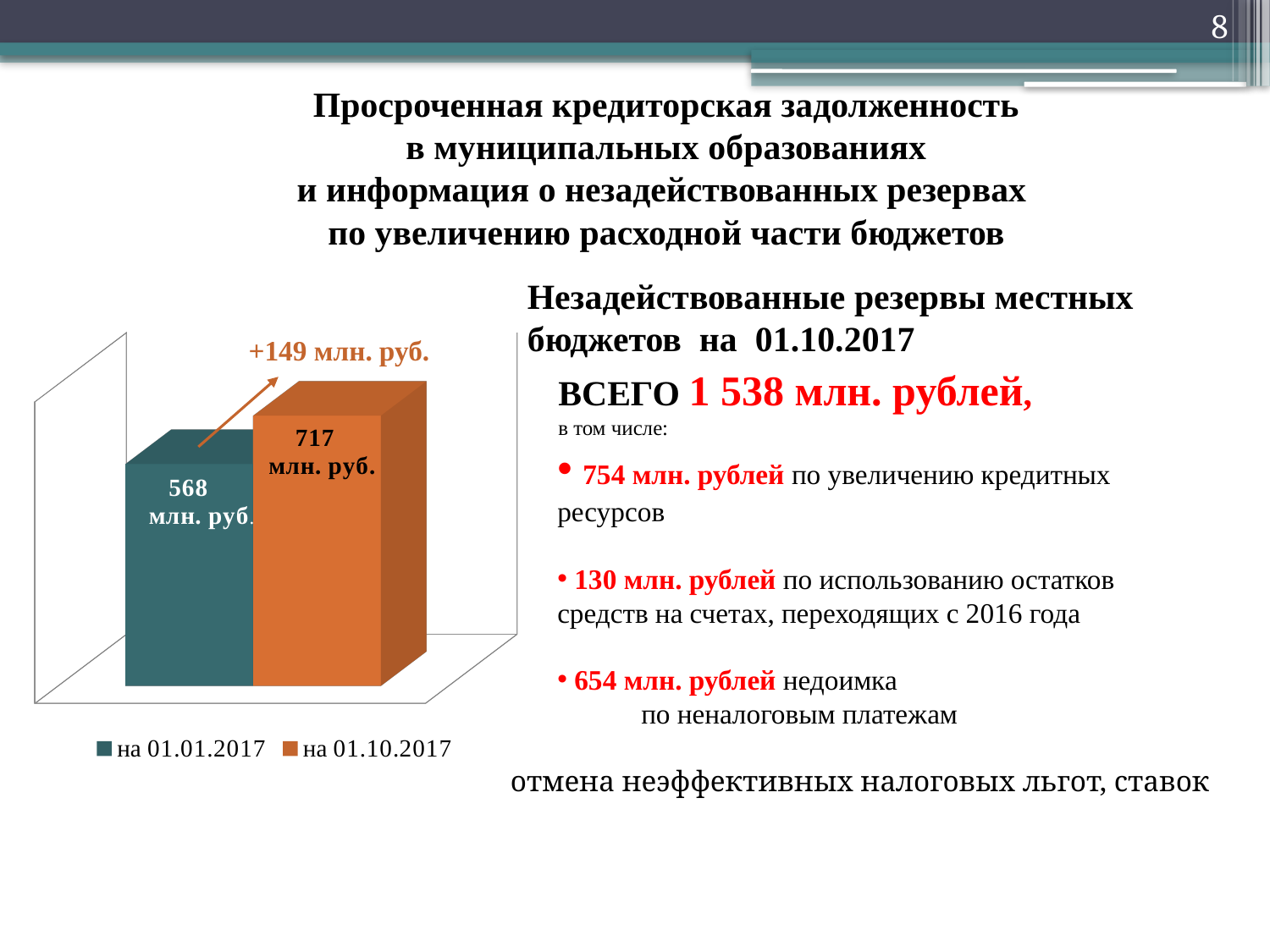
Does the value rise or fall from на 01.01.2017 to на 01.10.2017? rise What change is written in the annotation above the bars in the chart? +149 млн. руб. What is the value for на 01.10.2017 in the chart? 717 млн. руб. Is the value for на 01.01.2017 larger or smaller than the value for на 01.10.2017? smaller How many bars are plotted in the chart? 2 Which series has the higher value in the chart? на 01.10.2017 Which series has the lower value in the chart? на 01.01.2017 How many series does the chart legend list? 2 By how much does the value for на 01.10.2017 exceed the value for на 01.01.2017? 149 млн. руб. What colour is the bar for на 01.10.2017 in the chart? orange What kind of chart is shown on the slide? bar chart What is the value for на 01.01.2017 in the chart? 568 млн. руб.